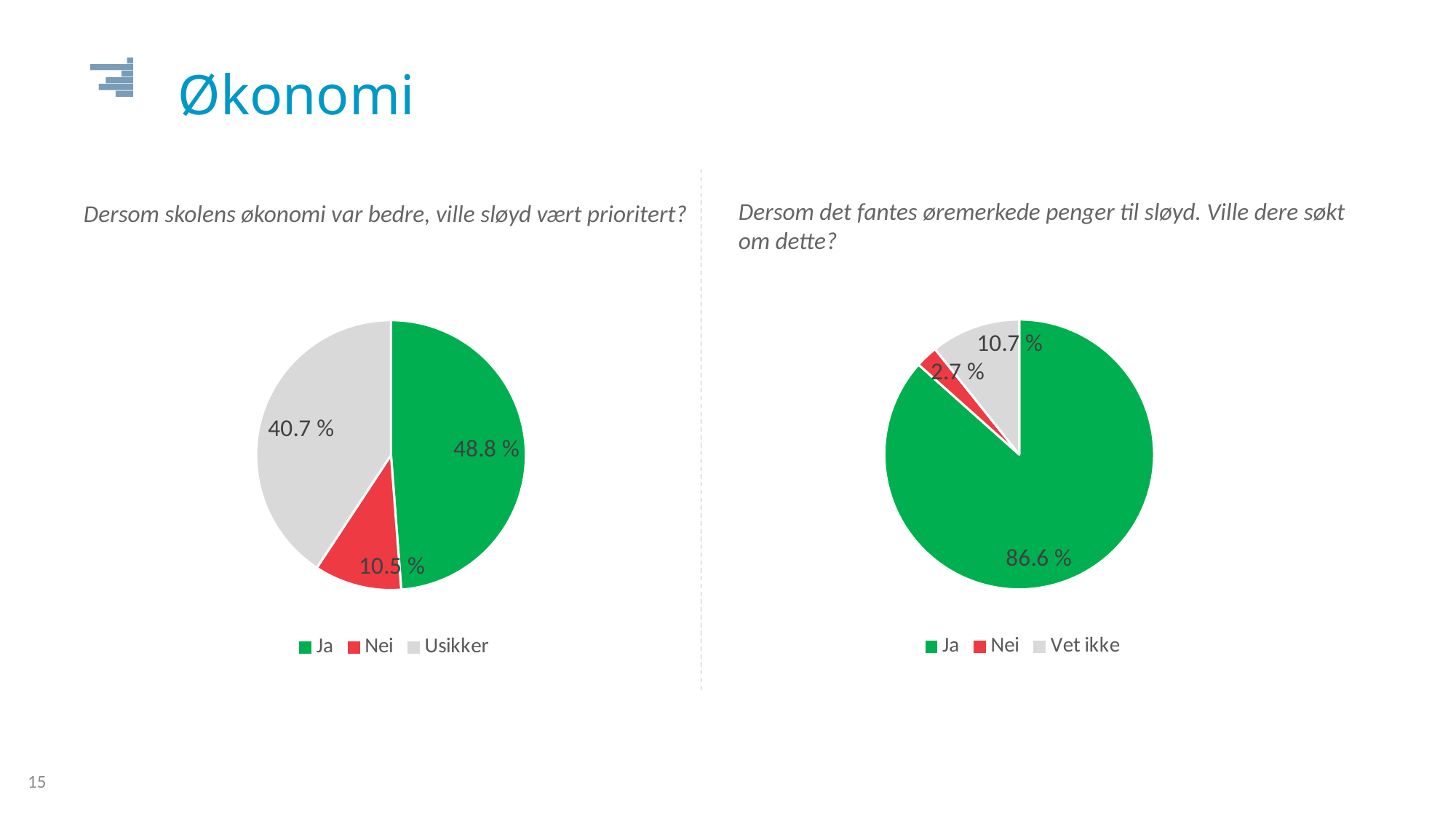
In the left pie chart, what share of respondents answered 'Ja'? 48.8 % In the left pie chart, what share of respondents answered 'Usikker'? 40.7 % In the right pie chart, which category has the smallest slice? Nei What type of chart is used on the right side of the slide? pie chart Which chart has the larger 'Ja' share, the left pie chart or the right pie chart? the right pie chart How many slices does the left pie chart have? 3 In the right pie chart, what share of respondents answered 'Vet ikke'? 10.7 % In the right pie chart, what is the difference in percentage points between 'Vet ikke' and 'Nei'? 8.0 In the left pie chart, what share of respondents answered 'Nei'? 10.5 % In the right pie chart, what share of respondents answered 'Ja'? 86.6 % In the left pie chart, which category has the largest slice? Ja In the left pie chart, what is the difference in percentage points between 'Ja' and 'Usikker'? 8.1